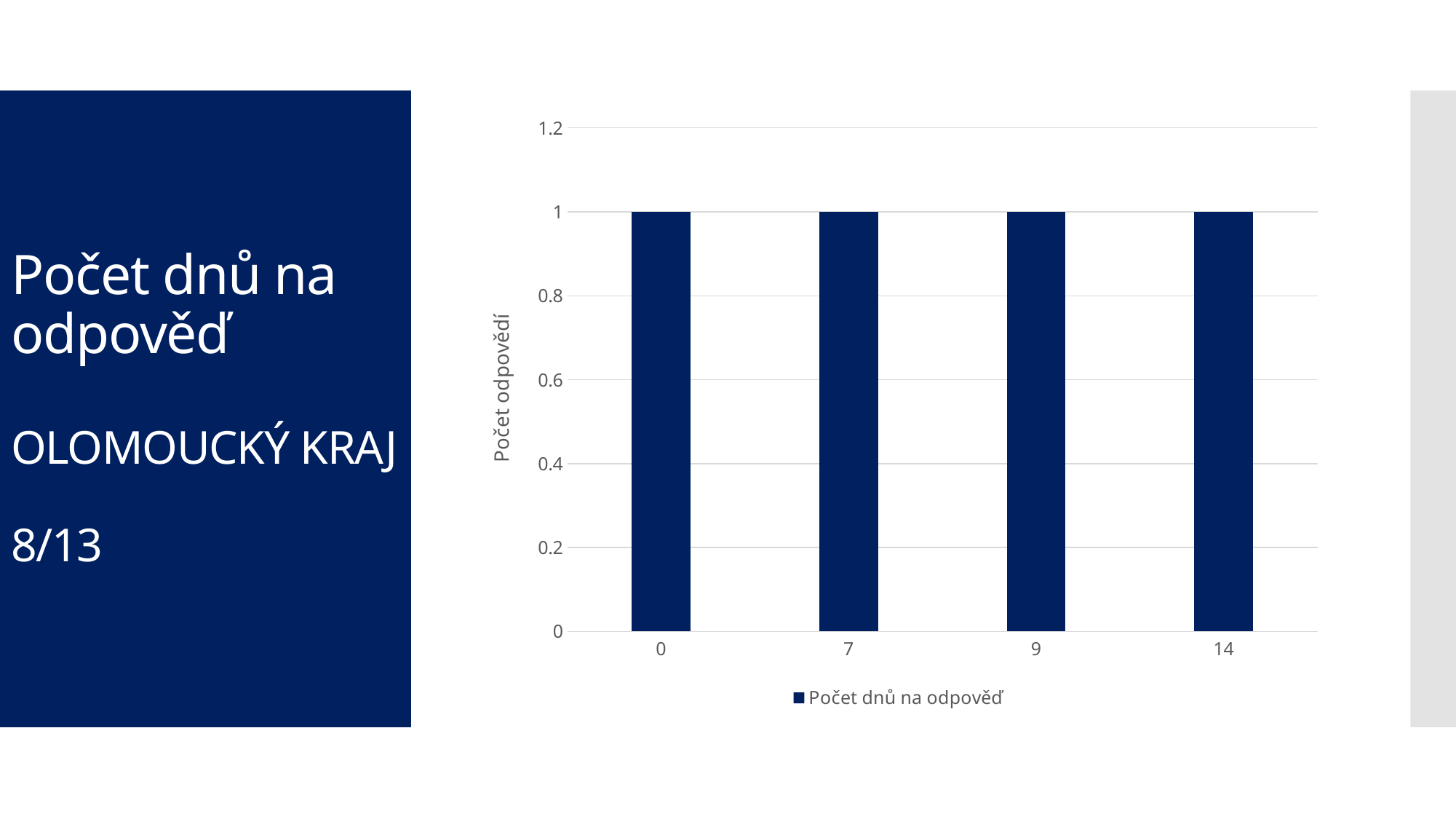
How many series does the chart legend list? 1 What is the value of the bar for category 9? 1 Is the value for category 9 greater or less than 0.8? greater What is the label of the vertical axis of the chart? Počet odpovědí What is the value of the bar for category 14? 1 How many categories are shown on the x axis of the chart? 4 Do the bar values rise, fall, or stay the same from left to right along the x axis? stay the same What is the value of the bar for category 0? 1 What kind of chart is shown on the slide? bar chart What is the difference between the values for category 7 and category 14? 0 What is the value of the bar for category 7? 1 What is the name of the series shown in the chart legend? Počet dnů na odpověď